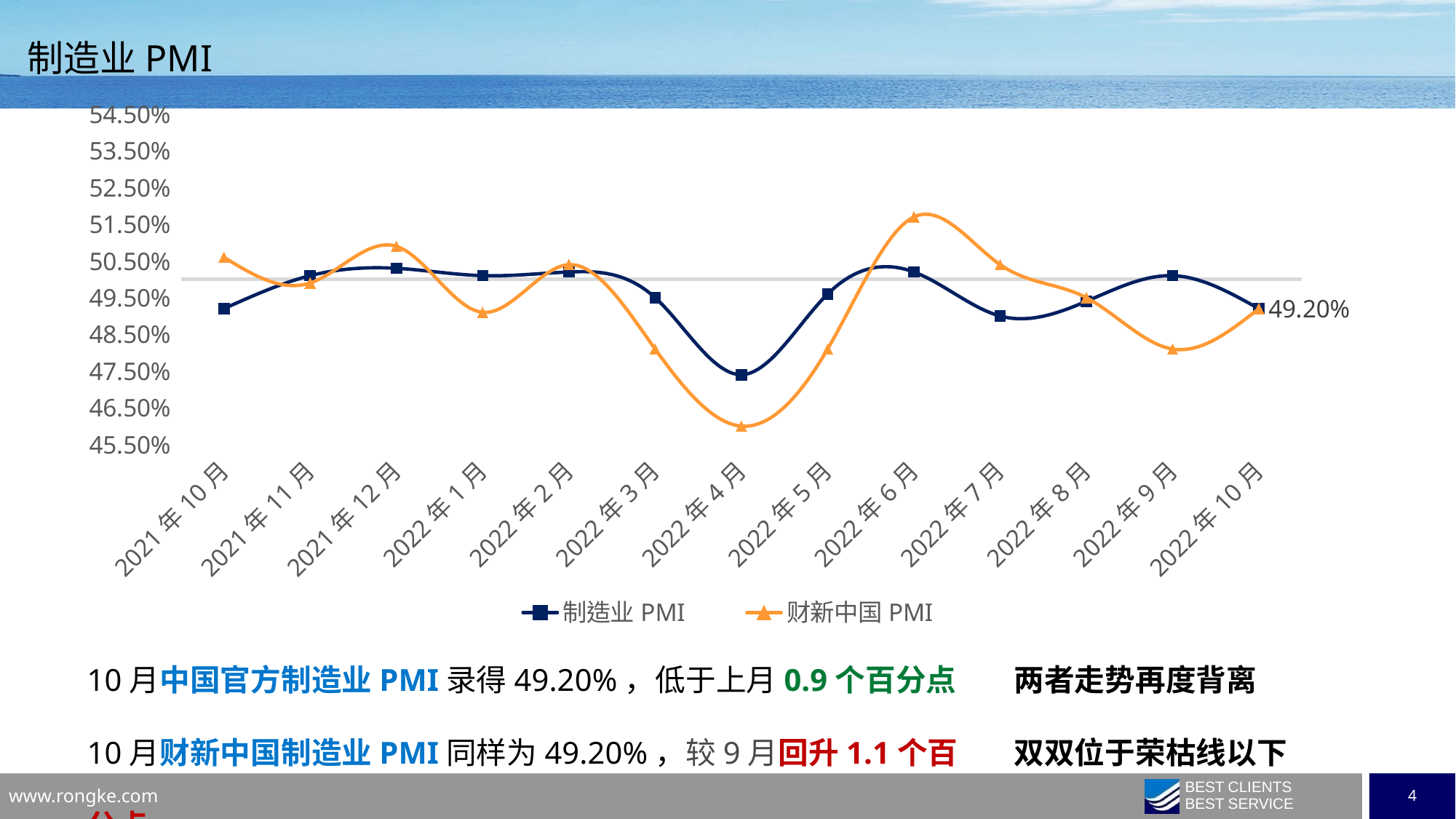
What are the two series named in the legend? 制造业 PMI and 财新中国 PMI Is the value of 财新中国 PMI for 2022年4月 greater or less than 46.50%? less What is the labelled value of 制造业 PMI for 2022年10月? 49.20% In which month does the 财新中国 PMI series reach its highest value? 2022年6月 In which month does the 制造业 PMI series reach its lowest value? 2022年4月 Is the value of 制造业 PMI for 2022年4月 greater or less than 48.50%? less In which month does the 财新中国 PMI series reach its lowest value? 2022年4月 How many months are plotted along the x axis? 13 What kind of chart is shown on the slide? line chart Does the 制造业 PMI series rise or fall from 2022年4月 to 2022年6月? rise In 2022年6月, which series has the higher value, 制造业 PMI or 财新中国 PMI? 财新中国 PMI How many series does the legend list? 2